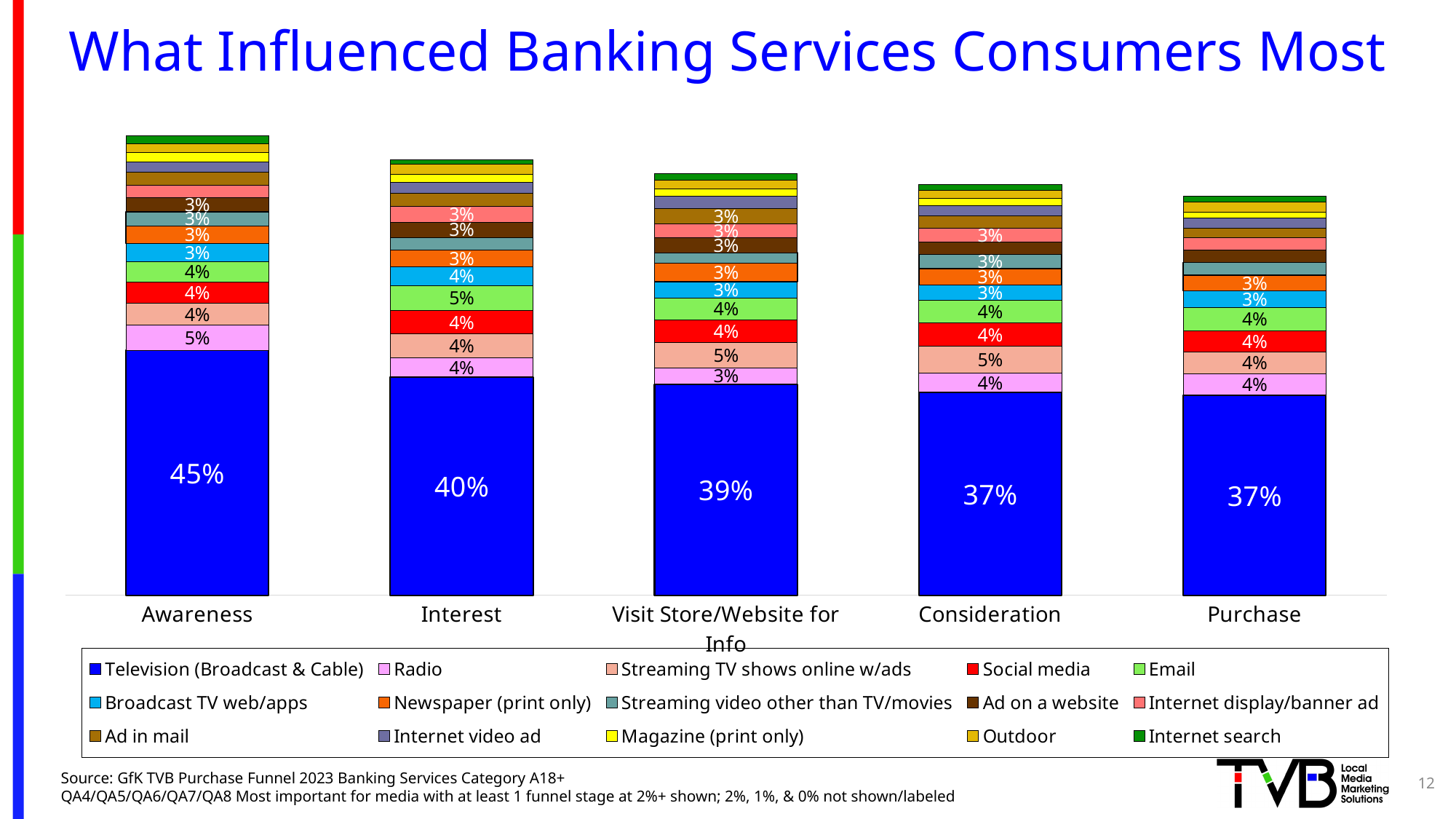
What is the value for Television (Broadcast & Cable) at the Purchase stage? 37% What is the value for Streaming TV shows online w/ads at the Consideration stage? 5% At which funnel stage is the Television (Broadcast & Cable) value highest? Awareness What is the value for Television (Broadcast & Cable) at the Awareness stage? 45% How many funnel stages (categories) are shown on the x axis? 5 What is the value for Radio at the Awareness stage? 5% Which is larger: the Television (Broadcast & Cable) value for Interest or for Visit Store/Website for Info? Interest How many series does the legend list? 15 What kind of chart is shown on the slide? Stacked bar chart What is the difference between the Television (Broadcast & Cable) values for Awareness and Purchase? 8 percentage points Does the Television (Broadcast & Cable) value rise or fall from Awareness to Purchase? Fall What is the value for Email at the Interest stage? 5%